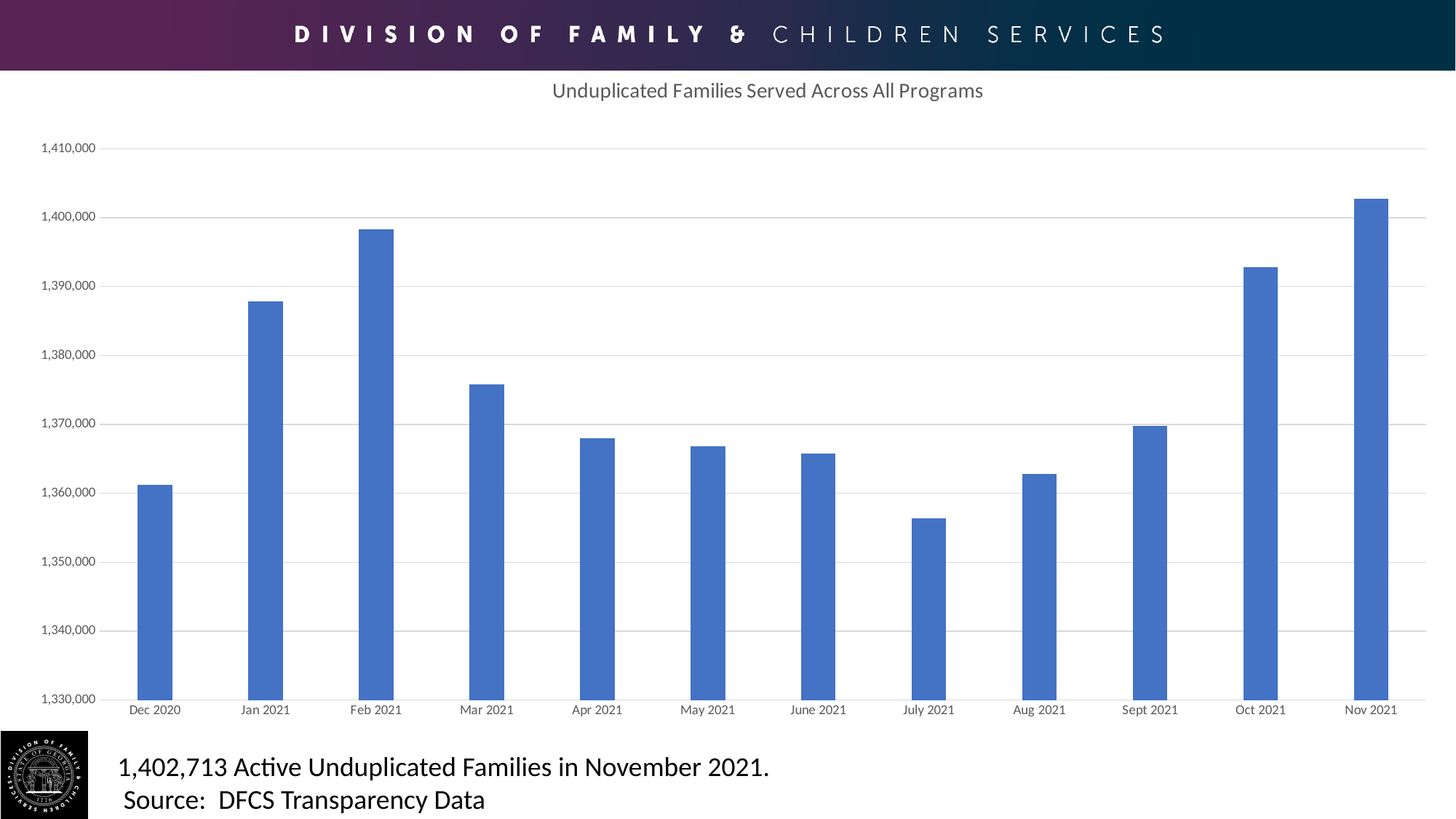
Which month has the larger value, Jan 2021 or Feb 2021? Feb 2021 What type of chart is shown on the slide? Bar chart Which month has the highest number of unduplicated families served? Nov 2021 Is the value for Jan 2021 greater or less than 1,380,000? greater Which month has the lowest number of unduplicated families served? July 2021 Do the values rise or fall from Apr 2021 to July 2021? fall Is the value for July 2021 greater or less than 1,360,000? less How many active unduplicated families were there in November 2021? 1,402,713 What is the title of the chart? Unduplicated Families Served Across All Programs What is the source of the data cited on the slide? DFCS Transparency Data How many months are shown on the x axis of the chart? 12 Is the value for Oct 2021 greater or less than 1,390,000? greater